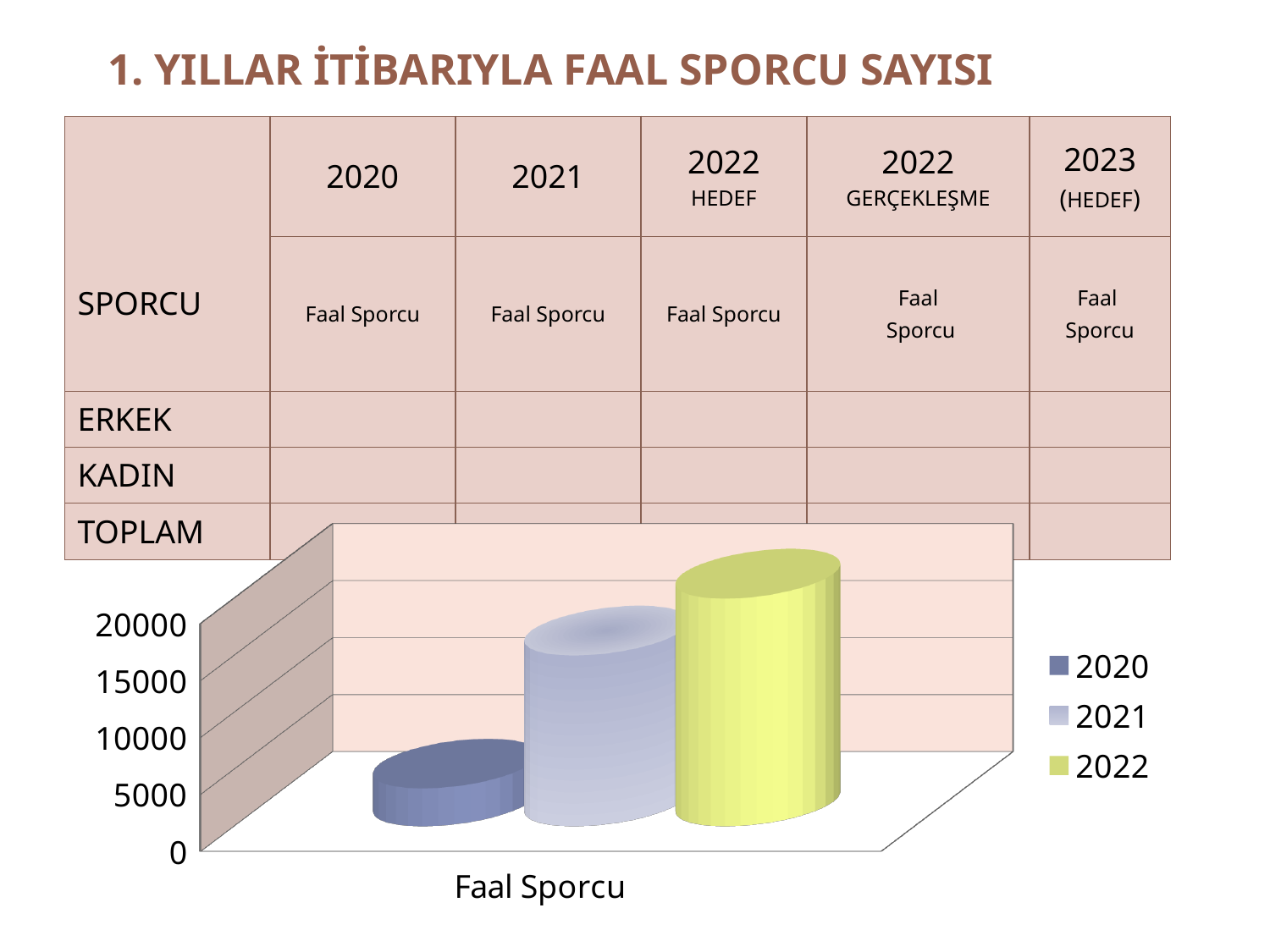
Is the value for 2020 in the chart greater or less than 10000? less Which series has the shortest bar in the chart? 2020 Is the value for 2021 in the chart greater or less than 10000? greater Which is larger in the chart, the bar for 2021 or the bar for 2022? 2022 Is the value for 2022 in the chart greater or less than 15000? greater Which is larger in the chart, the bar for 2020 or the bar for 2021? 2021 Do the bars in the chart get taller or shorter going from 2020 to 2022? taller Which series has the tallest bar in the chart? 2022 How many series does the chart legend list? 3 How many categories are shown on the x axis of the chart? 1 What is the category label shown on the x axis of the chart? Faal Sporcu What kind of chart is shown on the slide? bar chart